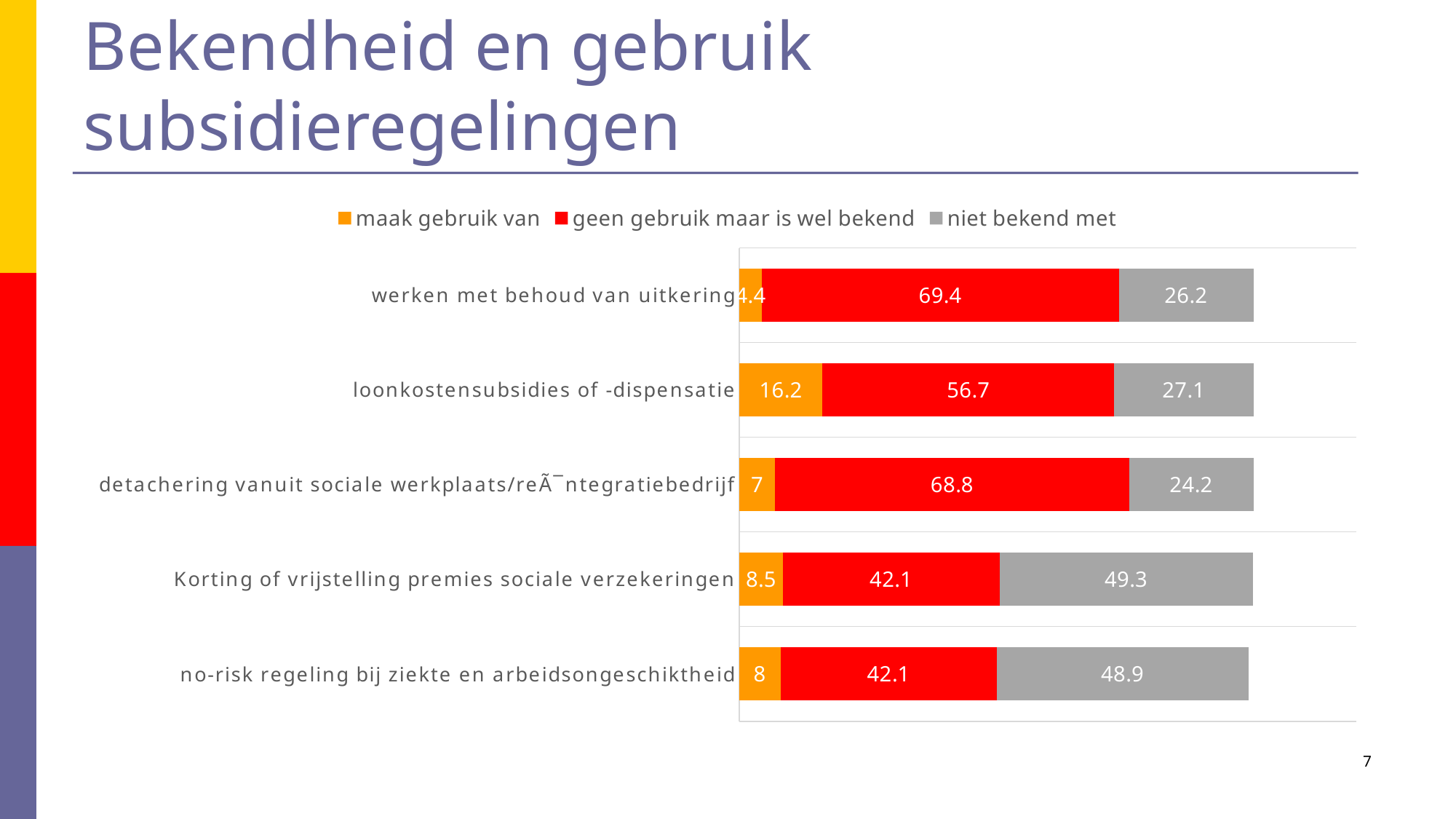
What is the difference between the 'niet bekend met' values for 'Korting of vrijstelling premies sociale verzekeringen' and 'werken met behoud van uitkering'? 23.1 What is the total of the stacked bar for 'no-risk regeling bij ziekte en arbeidsongeschiktheid'? 99 What is the value of 'maak gebruik van' for 'loonkostensubsidies of -dispensatie'? 16.2 Which category has the lowest value for 'maak gebruik van'? werken met behoud van uitkering How many categories (subsidy schemes) are shown in the chart? 5 What is the value of 'geen gebruik maar is wel bekend' for 'detachering vanuit sociale werkplaats'? 68.8 Which is larger: the 'niet bekend met' value for 'loonkostensubsidies of -dispensatie' or for 'detachering vanuit sociale werkplaats'? loonkostensubsidies of -dispensatie Which category has the highest value for 'maak gebruik van'? loonkostensubsidies of -dispensatie What kind of chart is shown on the slide? Stacked bar chart How many series does the legend list? 3 What is the value of 'niet bekend met' for 'werken met behoud van uitkering'? 26.2 Which category has the highest value for 'geen gebruik maar is wel bekend'? werken met behoud van uitkering